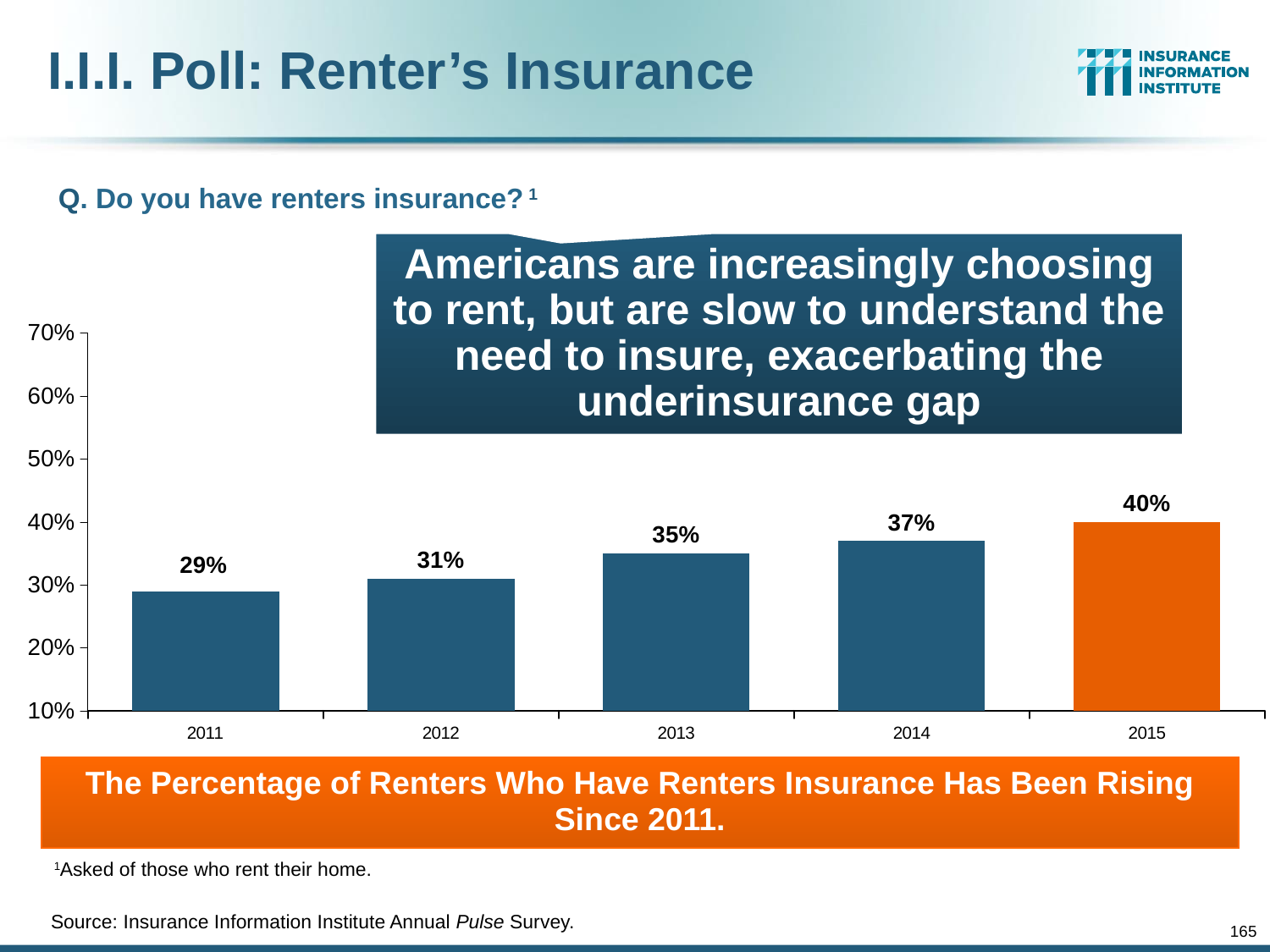
What is the value shown for 2013? 35% What is the difference between the 2014 and 2012 values? 6 percentage points Which year has the highest percentage of renters with renters insurance? 2015 Is the value for 2013 greater or less than 30%? greater Which year has a larger value, 2012 or 2014? 2014 Do the values rise or fall from 2011 to 2015? Rise What type of chart is used on this slide? Bar chart By how many percentage points did the value increase from 2011 to 2015? 11 percentage points What is the value shown for 2015? 40% What percentage of renters had renters insurance in 2011? 29% How many years are shown on the x axis of the chart? 5 Which year has the lowest percentage of renters with renters insurance? 2011